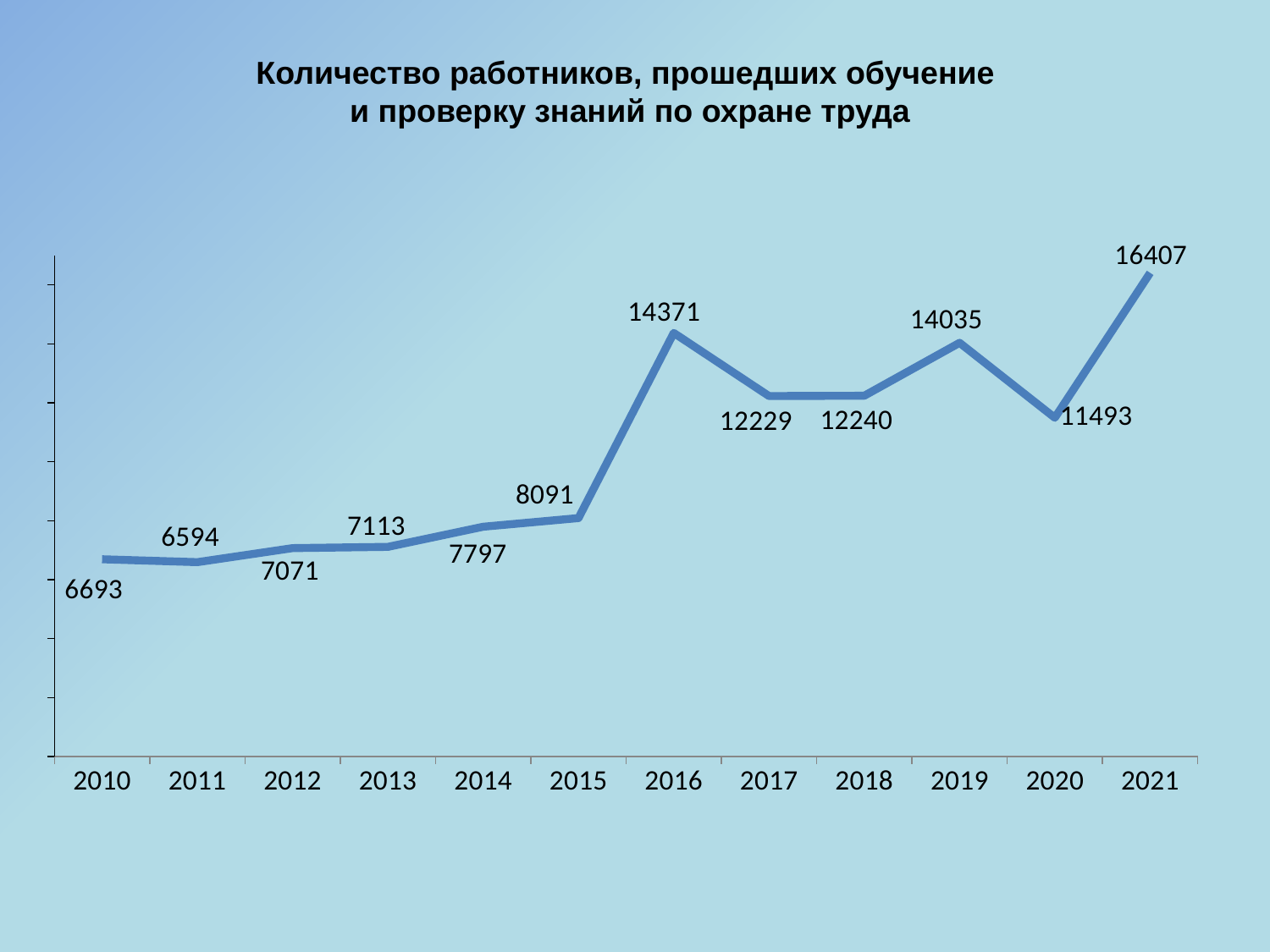
What is the value for 2016? 14371 What kind of chart is shown on the slide? line chart Which is larger, the value for 2019 or the value for 2017? 2019 Which year has the lowest value? 2011 Do the values rise or fall from 2010 to 2015? rise What is the value for 2010? 6693 How many years are plotted on the x axis? 12 What is the value for 2020? 11493 What is the title of the chart? Количество работников, прошедших обучение и проверку знаний по охране труда Which year has the highest value? 2021 What is the difference between the values for 2016 and 2015? 6280 What is the difference between the values for 2021 and 2020? 4914